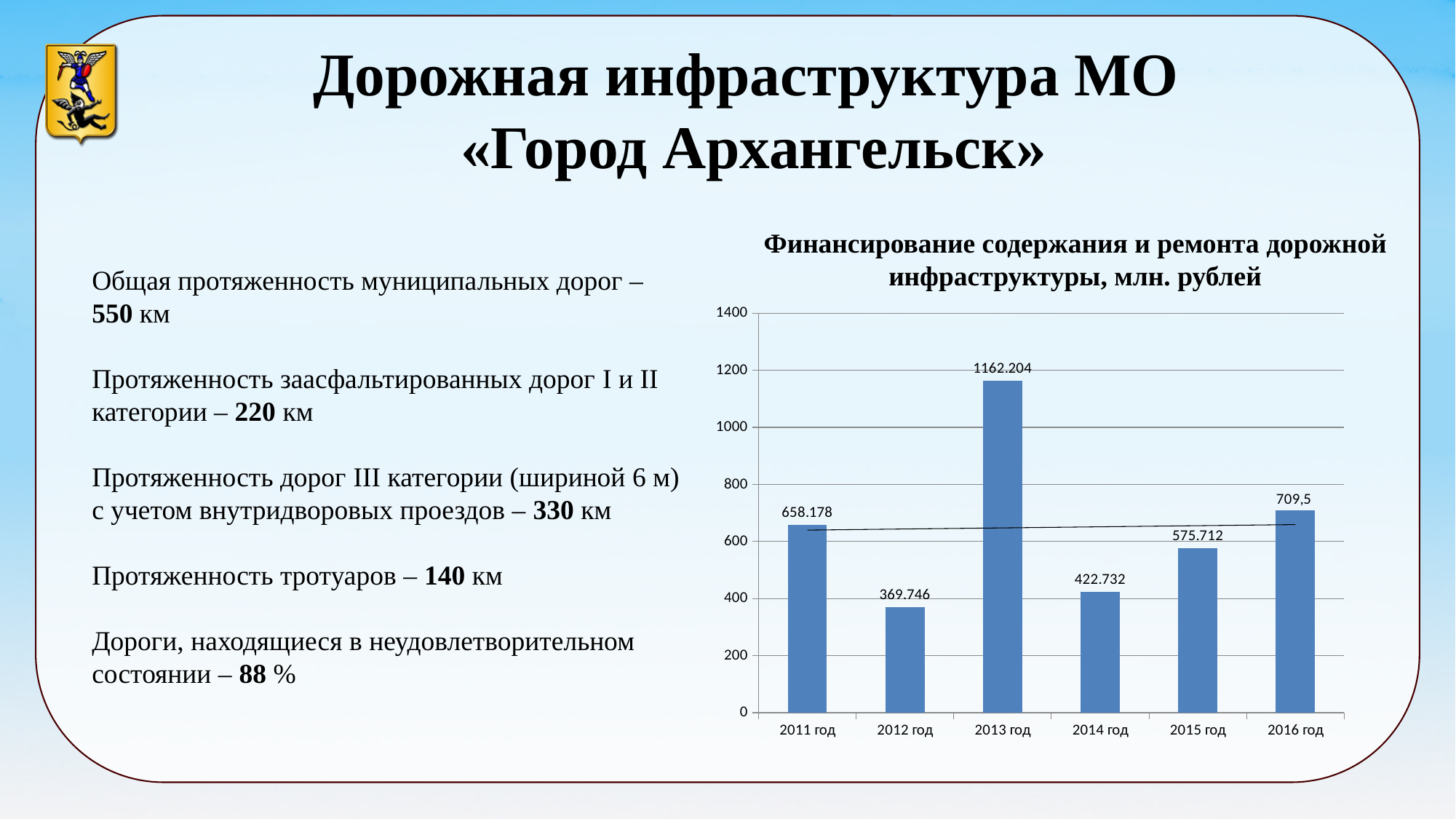
Which year has the highest value? 2013 год How many years are shown on the x axis? 6 What is the value for 2016 год? 709,5 What is the difference between the values for 2013 год and 2012 год? 792.458 What kind of chart is shown on the slide? bar chart What is the value for 2015 год? 575.712 What is the value for 2013 год? 1162.204 Which is larger, the value for 2011 год or the value for 2014 год? 2011 год What is the value for 2012 год? 369.746 Which year has the lowest value? 2012 год What is the difference between the values for 2015 год and 2014 год? 152.98 Do the values rise or fall from 2014 год to 2016 год? rise